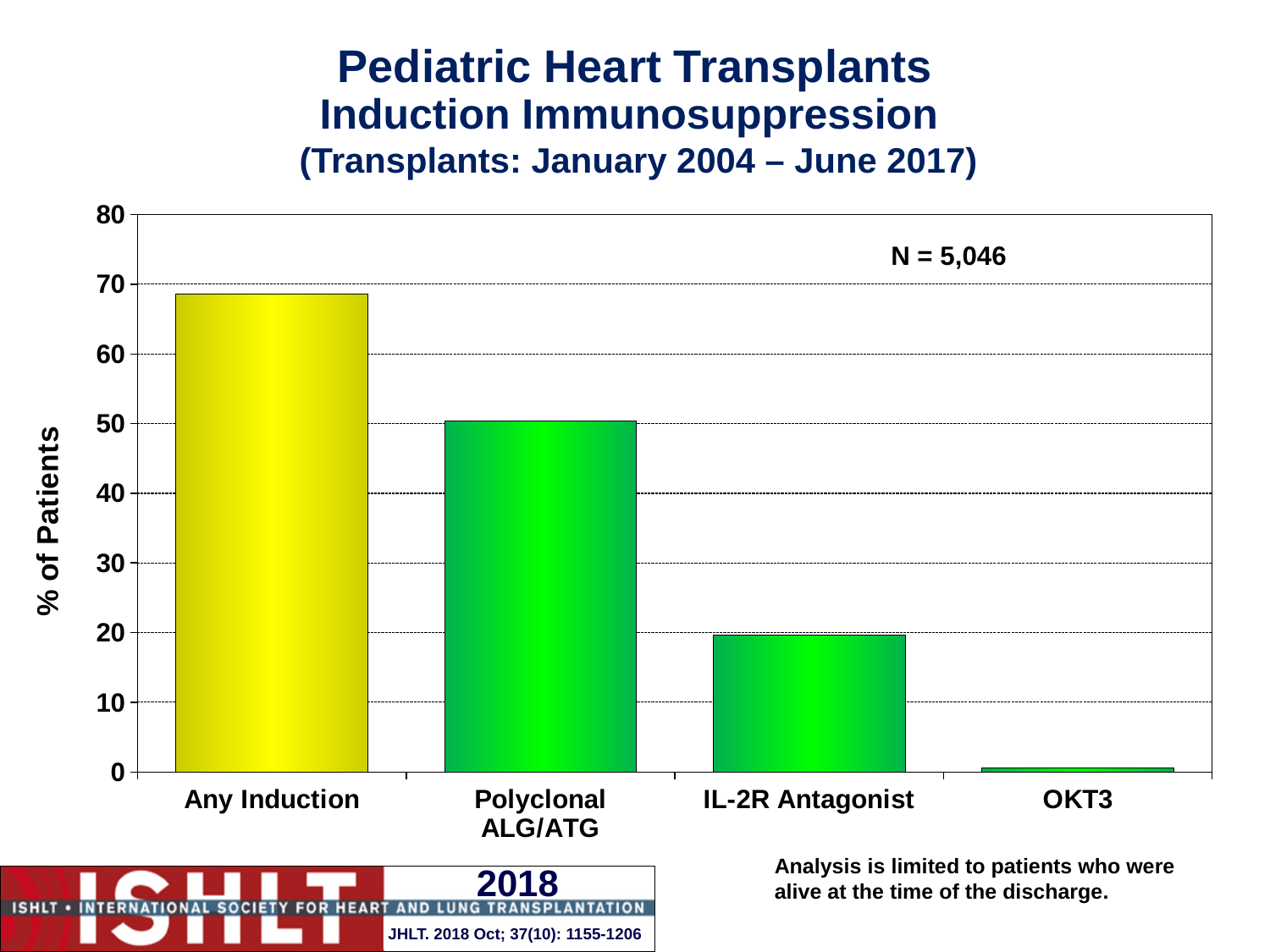
What is the N value shown on the chart? N = 5,046 Which is larger, the value for IL-2R Antagonist or the value for OKT3? IL-2R Antagonist Which category has the lowest % of patients? OKT3 Is the value for Any Induction greater or less than 60? greater Which category has the highest % of patients? Any Induction What kind of chart is shown on the slide? Bar chart Is the value for OKT3 greater or less than 10? less What is the label of the y axis? % of Patients Which is larger, the value for Polyclonal ALG/ATG or the value for IL-2R Antagonist? Polyclonal ALG/ATG How many categories are shown on the x axis of the chart? 4 Is the value for IL-2R Antagonist greater or less than 30? less